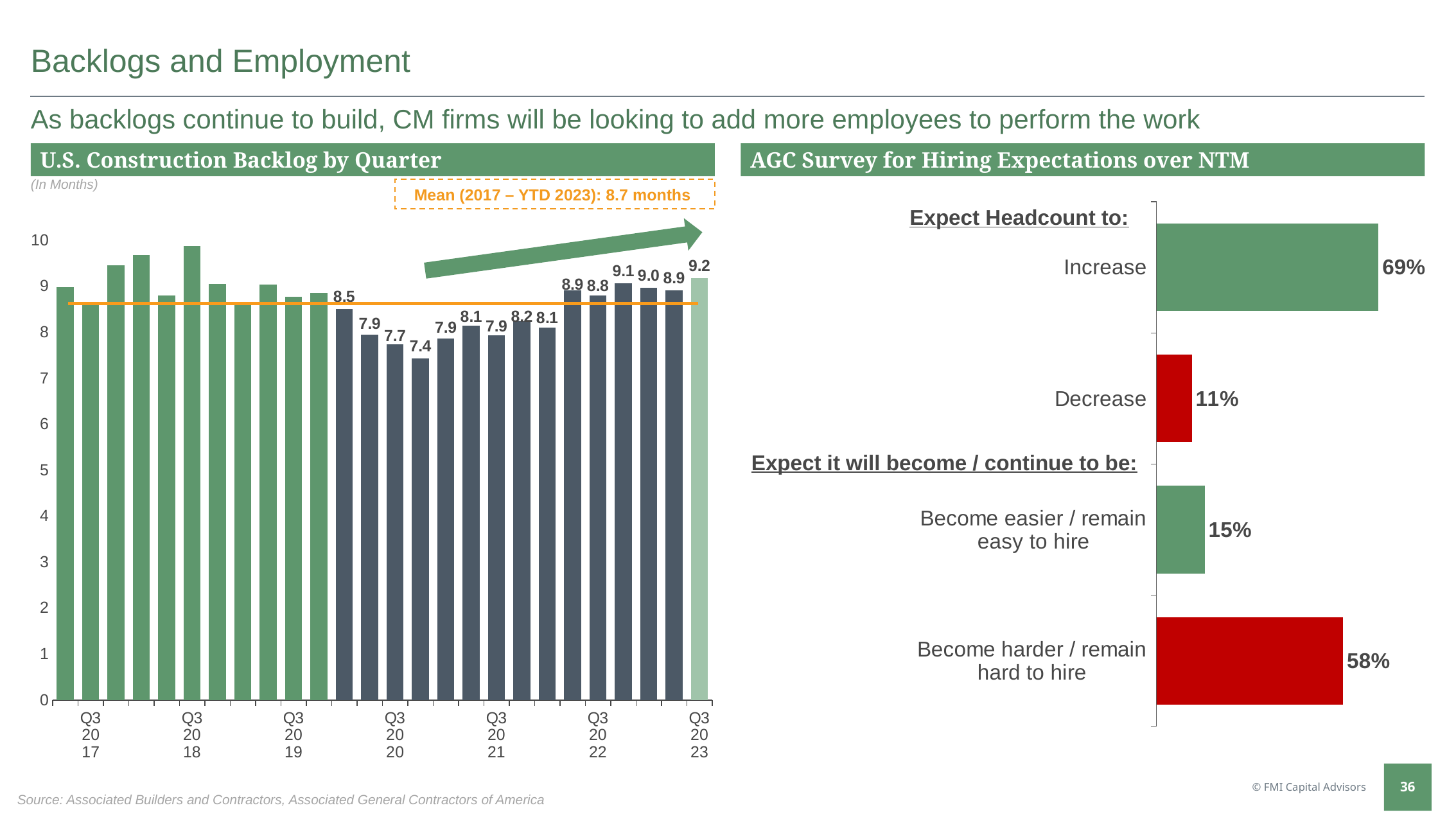
In the AGC Survey for Hiring Expectations over NTM chart, what percentage expect it will become harder / remain hard to hire? 58% In the U.S. Construction Backlog by Quarter chart, what is the lowest value shown as a data label? 7.4 In the AGC Survey for Hiring Expectations over NTM chart, which category has the highest percentage? Increase In the U.S. Construction Backlog by Quarter chart, what mean value is stated for 2017 – YTD 2023? 8.7 months In the U.S. Construction Backlog by Quarter chart, by how much does the Q3 2023 value exceed the Q3 2022 value? 0.4 In the U.S. Construction Backlog by Quarter chart, what is the backlog value for Q3 2022? 8.8 In the U.S. Construction Backlog by Quarter chart, what is the backlog value for Q3 2020? 7.7 In the U.S. Construction Backlog by Quarter chart, what is the backlog value for Q3 2023? 9.2 In the AGC Survey for Hiring Expectations over NTM chart, what percentage expect headcount to increase? 69% In the U.S. Construction Backlog by Quarter chart, is the value for Q3 2019 greater or less than 8? greater In the U.S. Construction Backlog by Quarter chart, which is larger, the value for Q3 2023 or Q3 2022? Q3 2023 In the AGC Survey for Hiring Expectations over NTM chart, how many categories are plotted? 4